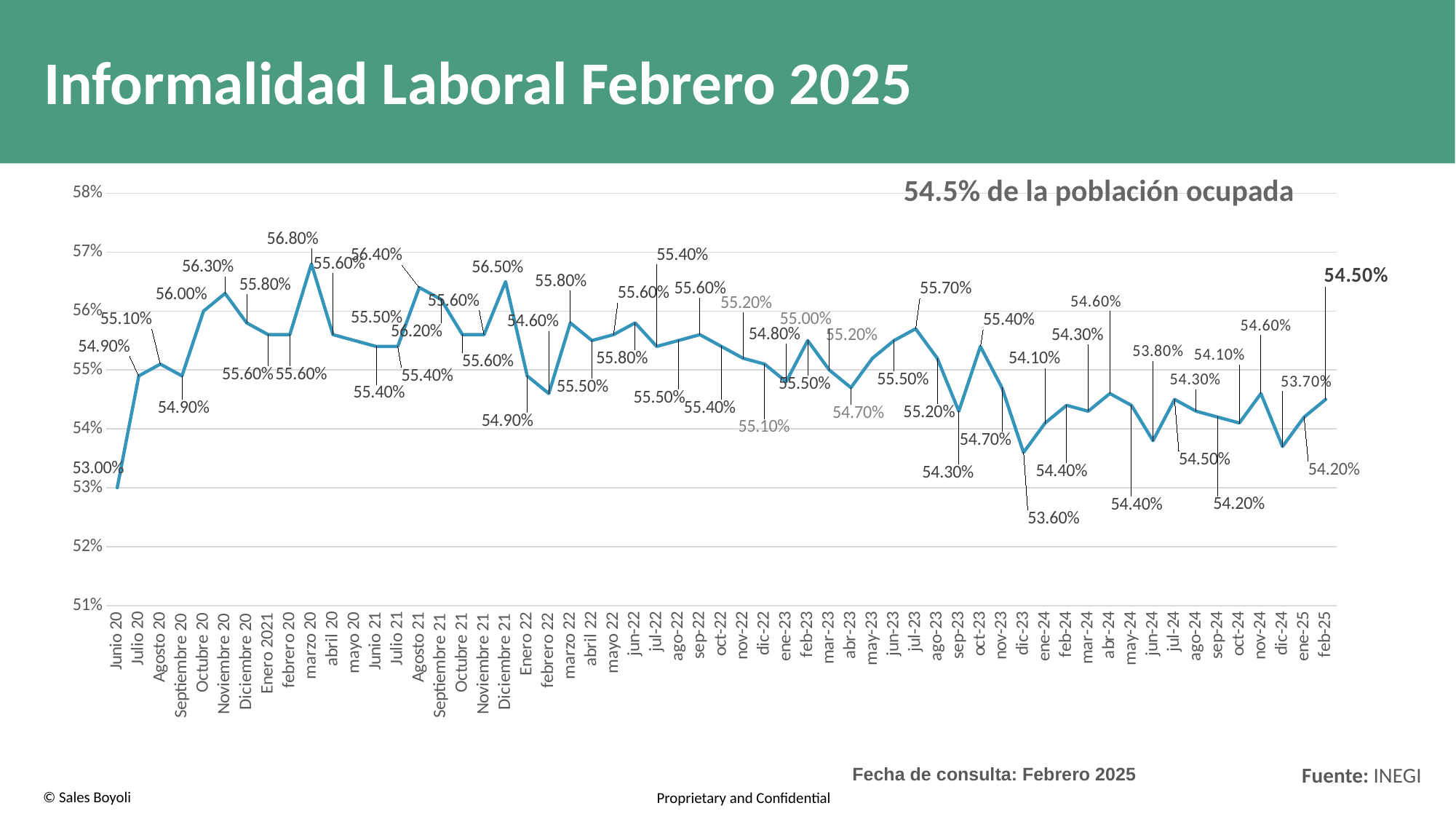
What is the value for feb-25? 54.50% Which month has the highest value on the chart? marzo 20 What is the title of the slide containing the chart? Informalidad Laboral Febrero 2025 Does the line rise or fall from jul-23 to dic-23? fall Is the value for dic-23 greater or less than 54%? less What is the value for dic-23? 53.60% What is the value for Junio 20? 53.00% Which month has the lowest value on the chart? Junio 20 What is the difference between the highest value (marzo 20) and the lowest value (Junio 20)? 3.80 percentage points Is the value for marzo 20 greater or less than 56%? greater Which is larger, the value for marzo 20 or the value for feb-25? marzo 20 What kind of chart is shown on the slide? Line chart